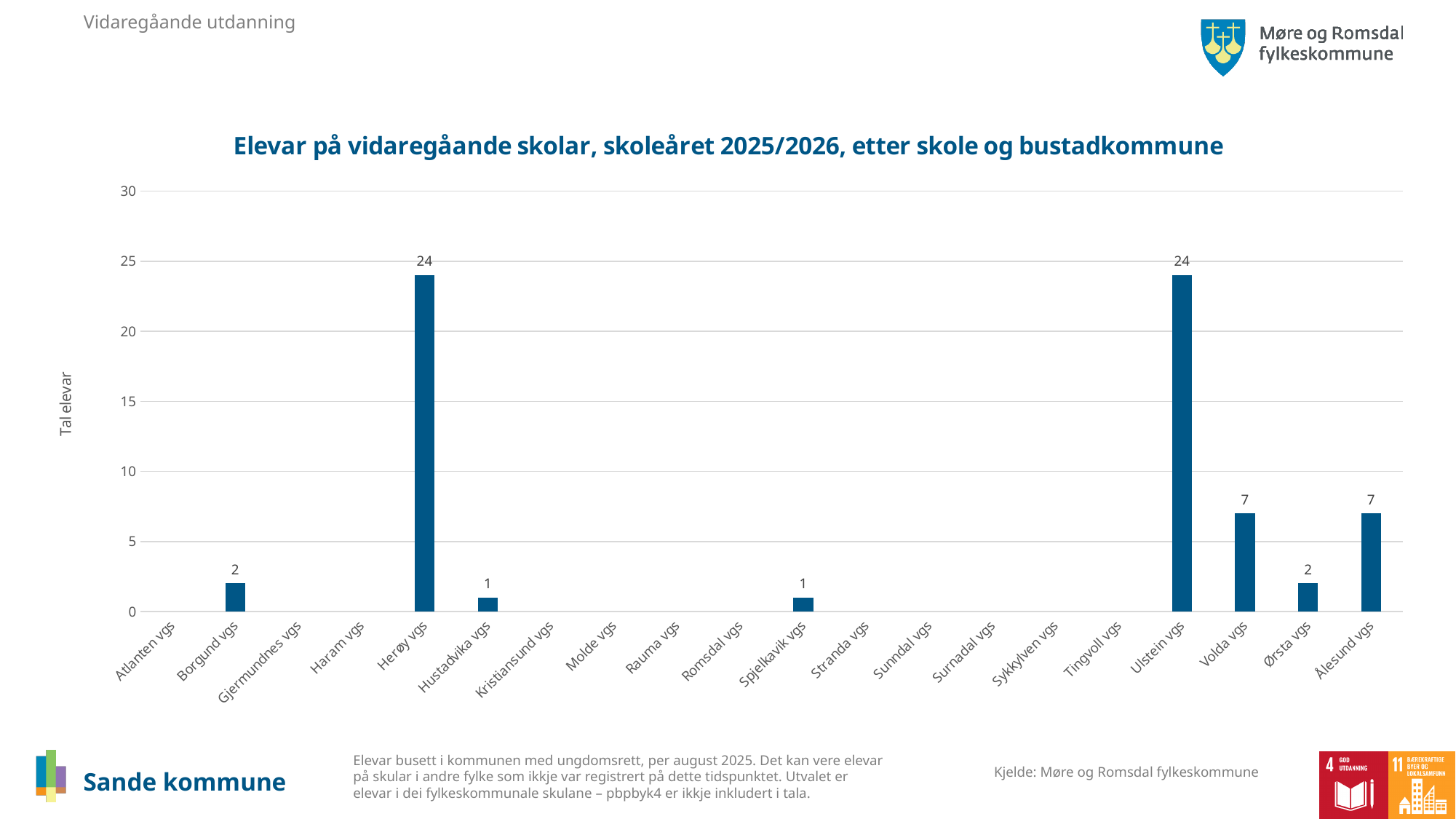
What is the difference between the values for Ulstein vgs and Volda vgs? 17 What kind of chart is shown on the slide? bar chart What is the difference between the values for Herøy vgs and Borgund vgs? 22 What is the value for Herøy vgs? 24 What is the value for Volda vgs? 7 Is the value for Herøy vgs greater or less than 20? greater What is the value for Hustadvika vgs? 1 What is the value for Borgund vgs? 2 How many schools are listed on the x axis? 20 Which is larger, the value for Ålesund vgs or the value for Ørsta vgs? Ålesund vgs What is the value for Ulstein vgs? 24 What is the label of the y axis? Tal elevar